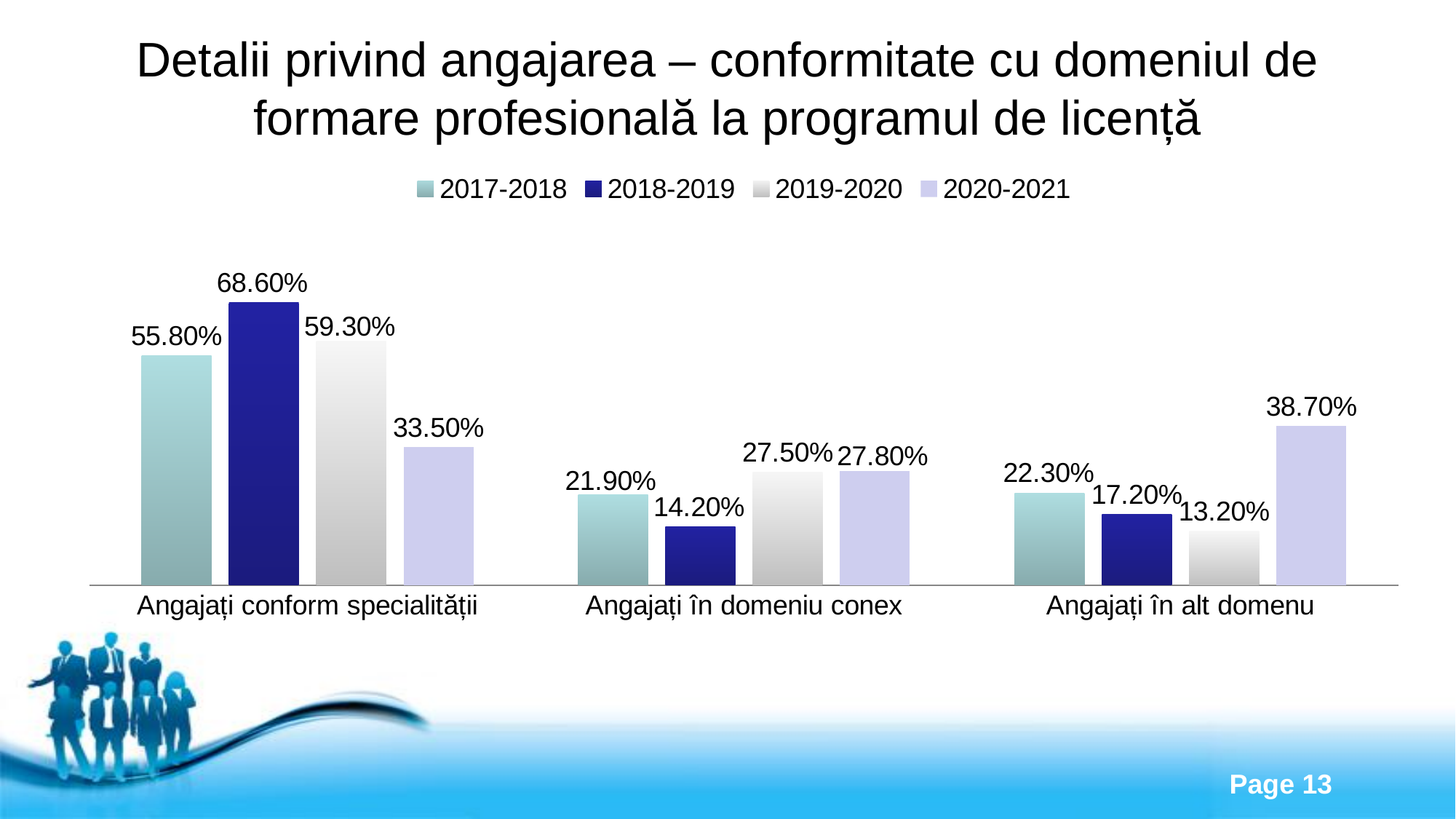
What kind of chart is shown on the slide? Bar chart Does the 2020-2021 series rise or fall from 'Angajați în domeniu conex' to 'Angajați în alt domenu'? Rise What is the value for 2020-2021 in the 'Angajați în alt domenu' category? 38.70% Which series has the lowest value in the 'Angajați în alt domenu' category? 2019-2020 How many series does the legend list? 4 What is the difference between the 2018-2019 and 2020-2021 values in the 'Angajați conform specialității' category? 35.10% What is the value for 2018-2019 in the 'Angajați conform specialității' category? 68.60% How many categories are shown on the x axis? 3 Which series has the highest value in the 'Angajați conform specialității' category? 2018-2019 Which is larger: the 2017-2018 value for 'Angajați în domeniu conex' or the 2017-2018 value for 'Angajați în alt domenu'? Angajați în alt domenu Which series is shown in dark blue in the legend? 2018-2019 What is the value for 2017-2018 in the 'Angajați în domeniu conex' category? 21.90%